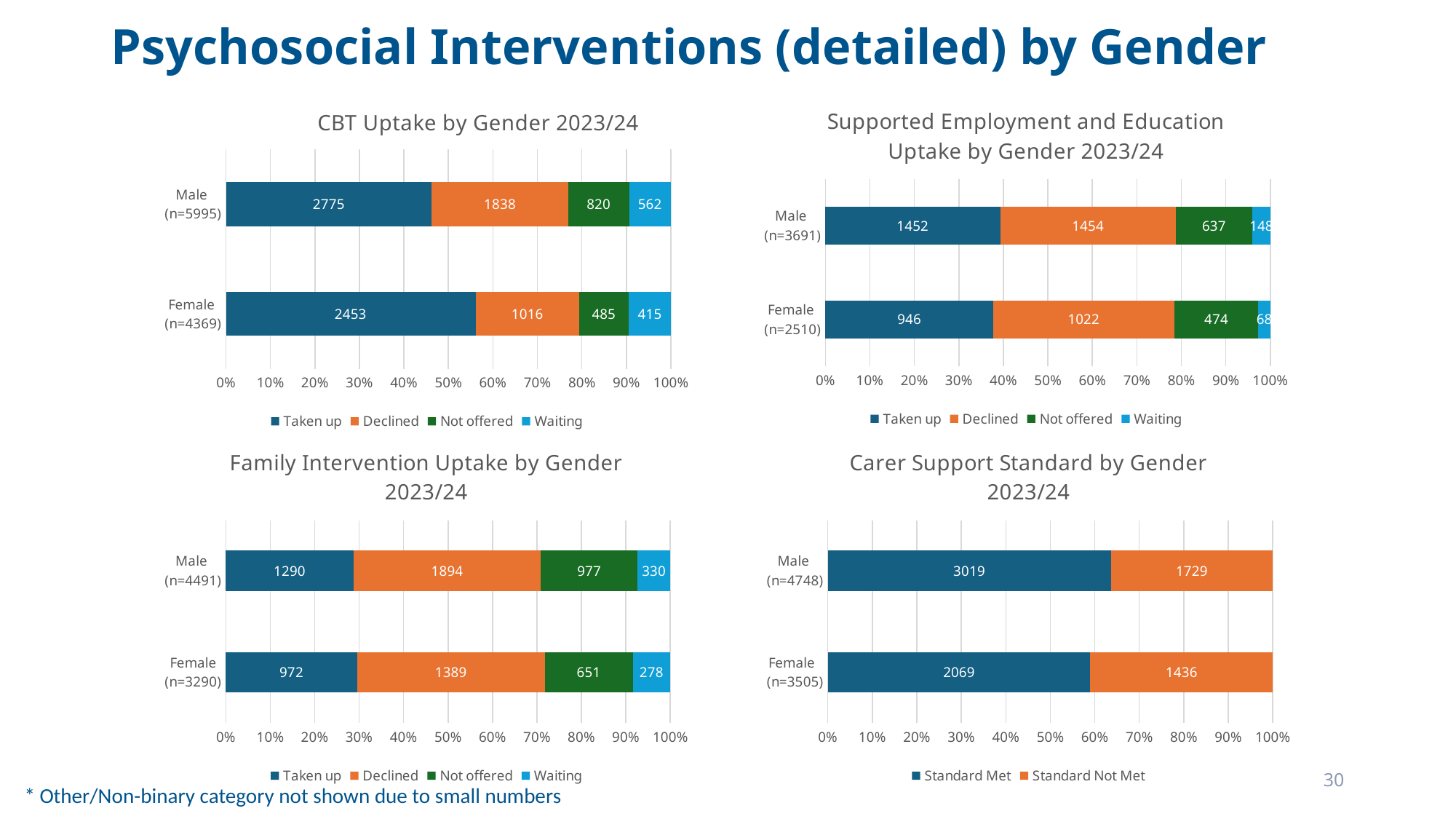
In the CBT Uptake by Gender 2023/24 chart, what is the total of the Male bar? 5995 In the Family Intervention Uptake by Gender 2023/24 chart, which is larger for Male: Taken up or Declined? Declined In the Family Intervention Uptake by Gender 2023/24 chart, which series has the largest value in the Female bar? Declined In the Carer Support Standard by Gender 2023/24 chart, how much larger is the Standard Met value for Male than for Female? 950 In the Carer Support Standard by Gender 2023/24 chart, what is the Standard Not Met value for Male? 1729 In the CBT Uptake by Gender 2023/24 chart, what is the difference between the Taken up values for Male and Female? 322 What kind of chart is the Carer Support Standard by Gender 2023/24 chart? Stacked bar chart In the Supported Employment and Education Uptake by Gender 2023/24 chart, which series has the smallest value in the Female bar? Waiting In the Carer Support Standard by Gender 2023/24 chart, is the Standard Met share of the Female bar greater or less than 50%? greater In the Supported Employment and Education Uptake by Gender 2023/24 chart, what is the Declined value for Female? 1022 How many series does the legend of the Supported Employment and Education Uptake by Gender 2023/24 chart list? 4 In the CBT Uptake by Gender 2023/24 chart, what is the Taken up value for Male? 2775